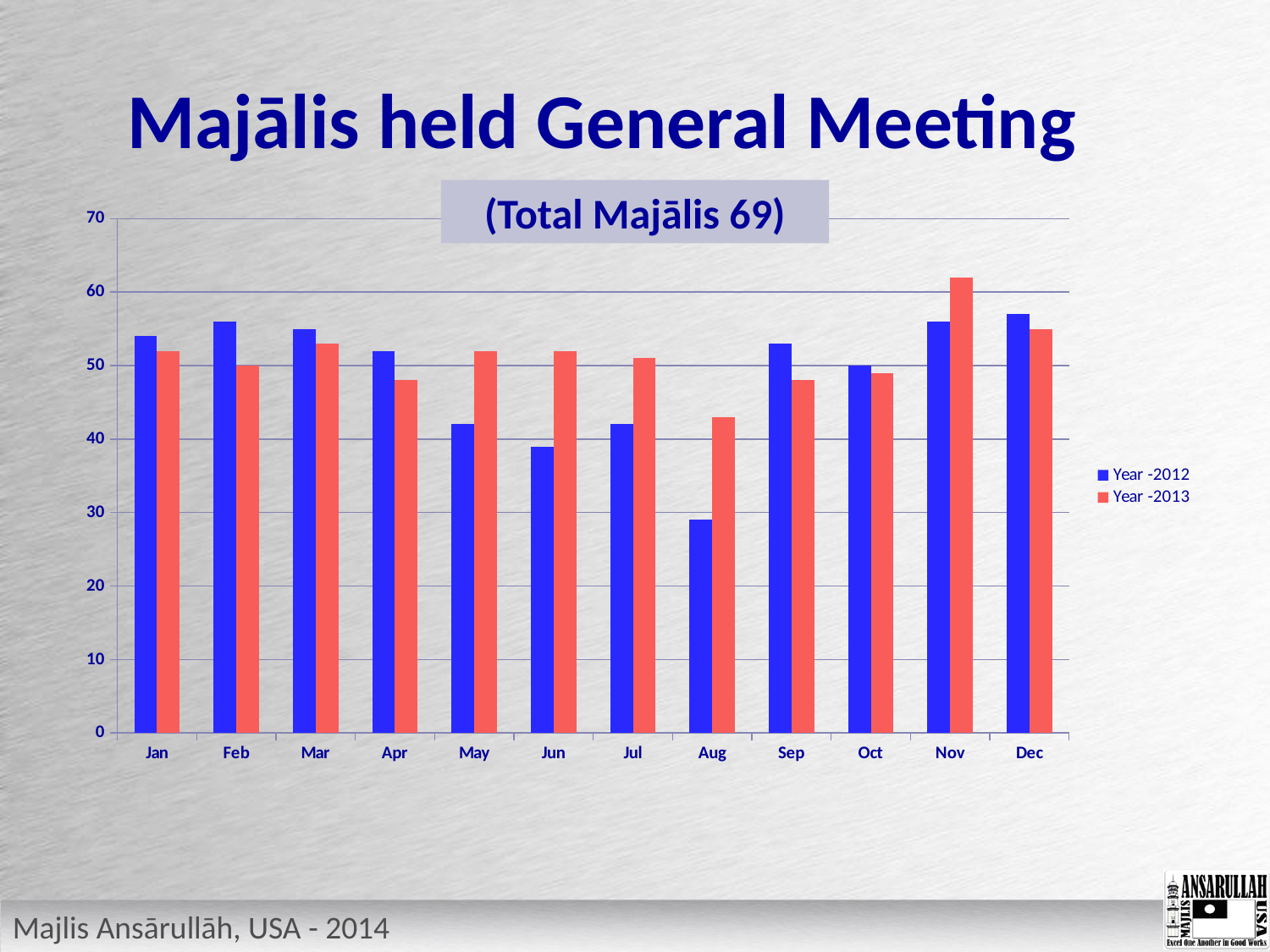
How many months are shown on the x axis? 12 Which month has the highest value for Year -2013? Nov Which month has the lowest value for Year -2012? Aug Which month has the lowest value for Year -2013? Aug In Feb, which series has the larger value, Year -2012 or Year -2013? Year -2012 In Jun, which series has the larger value, Year -2012 or Year -2013? Year -2013 What is the title shown inside the chart area? (Total Majālis 69) How many series does the legend list? 2 What kind of chart is shown on the slide? bar chart Is the value for Year -2012 in Aug greater or less than 40? less Is the value for Year -2013 in Nov greater or less than 60? greater Is the value for Year -2013 in Aug greater or less than 50? less